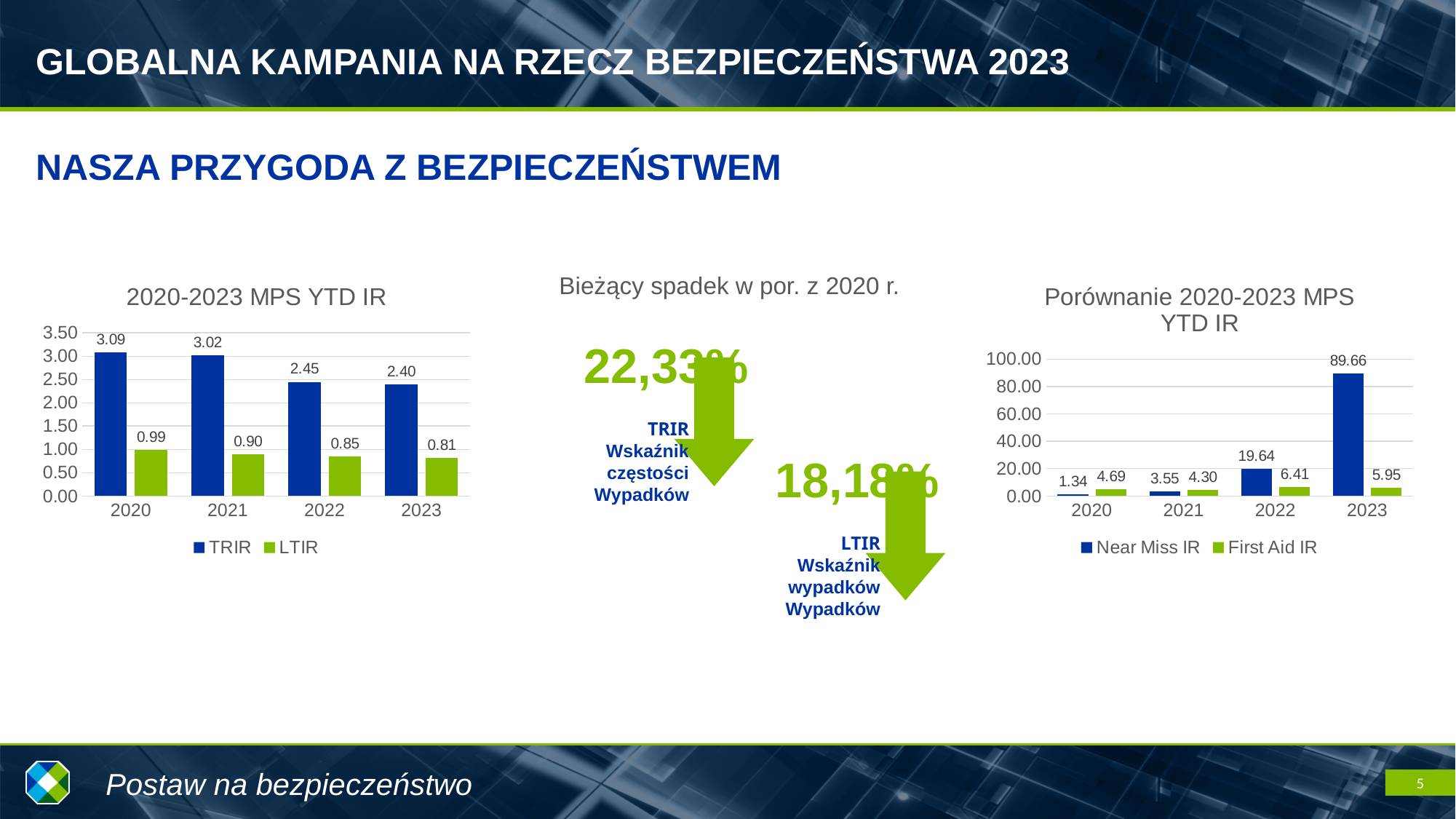
In the chart titled "2020-2023 MPS YTD IR", which year has the highest TRIR value? 2020 In the chart titled "Porównanie 2020-2023 MPS YTD IR", which year has the lowest Near Miss IR value? 2020 In the chart titled "2020-2023 MPS YTD IR", does the TRIR series rise or fall from 2020 to 2023? fall What type of chart is the chart titled "Porównanie 2020-2023 MPS YTD IR"? bar chart In the chart titled "2020-2023 MPS YTD IR", what is the TRIR value for 2022? 2.45 In the chart titled "Porównanie 2020-2023 MPS YTD IR", what is the First Aid IR value for 2021? 4.30 In the chart titled "Porównanie 2020-2023 MPS YTD IR", how many years are shown on the x axis? 4 In the chart titled "2020-2023 MPS YTD IR", what is the LTIR value for 2023? 0.81 In the chart titled "Porównanie 2020-2023 MPS YTD IR", which is larger in 2020: Near Miss IR or First Aid IR? First Aid IR In the chart titled "2020-2023 MPS YTD IR", how many series does the legend list? 2 In the chart titled "Porównanie 2020-2023 MPS YTD IR", what is the Near Miss IR value for 2023? 89.66 In the chart titled "2020-2023 MPS YTD IR", what is the difference between the TRIR values for 2020 and 2023? 0.69